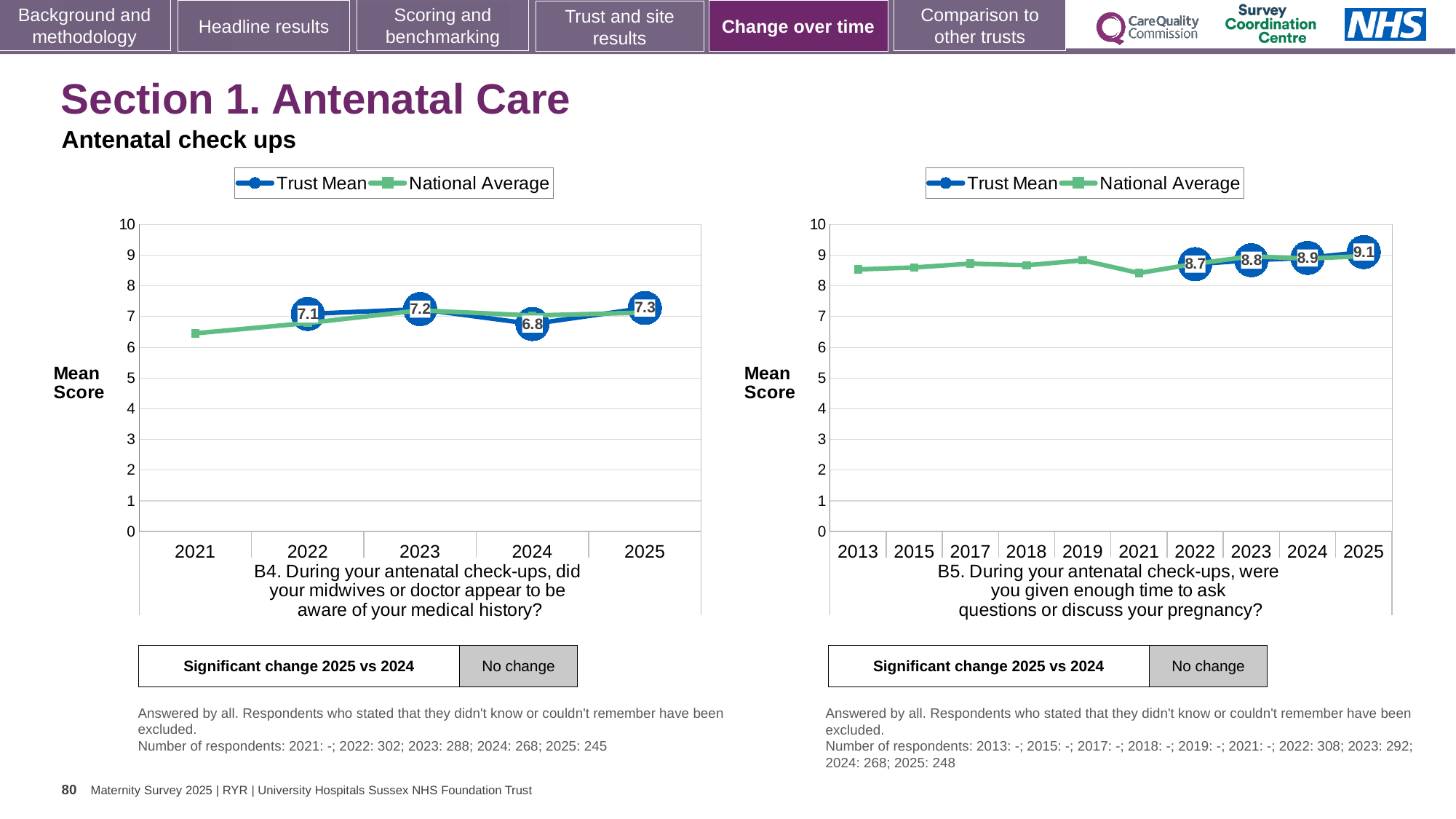
In the left chart (B4), which year has the lowest Trust Mean score? 2024 In the left chart (B4), is the National Average value for 2021 greater or less than 7? less How many series does the legend of the left chart (B4) list? 2 In the right chart (B5), which year has the highest Trust Mean score? 2025 In the right chart (B5), what is the Trust Mean score for 2022? 8.7 How many years are shown on the x axis of the right chart (B5)? 10 In the right chart (B5), is the Trust Mean score for 2023 larger or smaller than the score for 2024? smaller In the right chart (B5), does the Trust Mean score rise or fall from 2022 to 2025? rise In the left chart (B4), what is the Trust Mean score for 2025? 7.3 In the right chart (B5), what is the Trust Mean score for 2025? 9.1 In the left chart (B4), what is the Trust Mean score for 2024? 6.8 In the left chart (B4), what is the difference between the Trust Mean scores for 2025 and 2024? 0.5